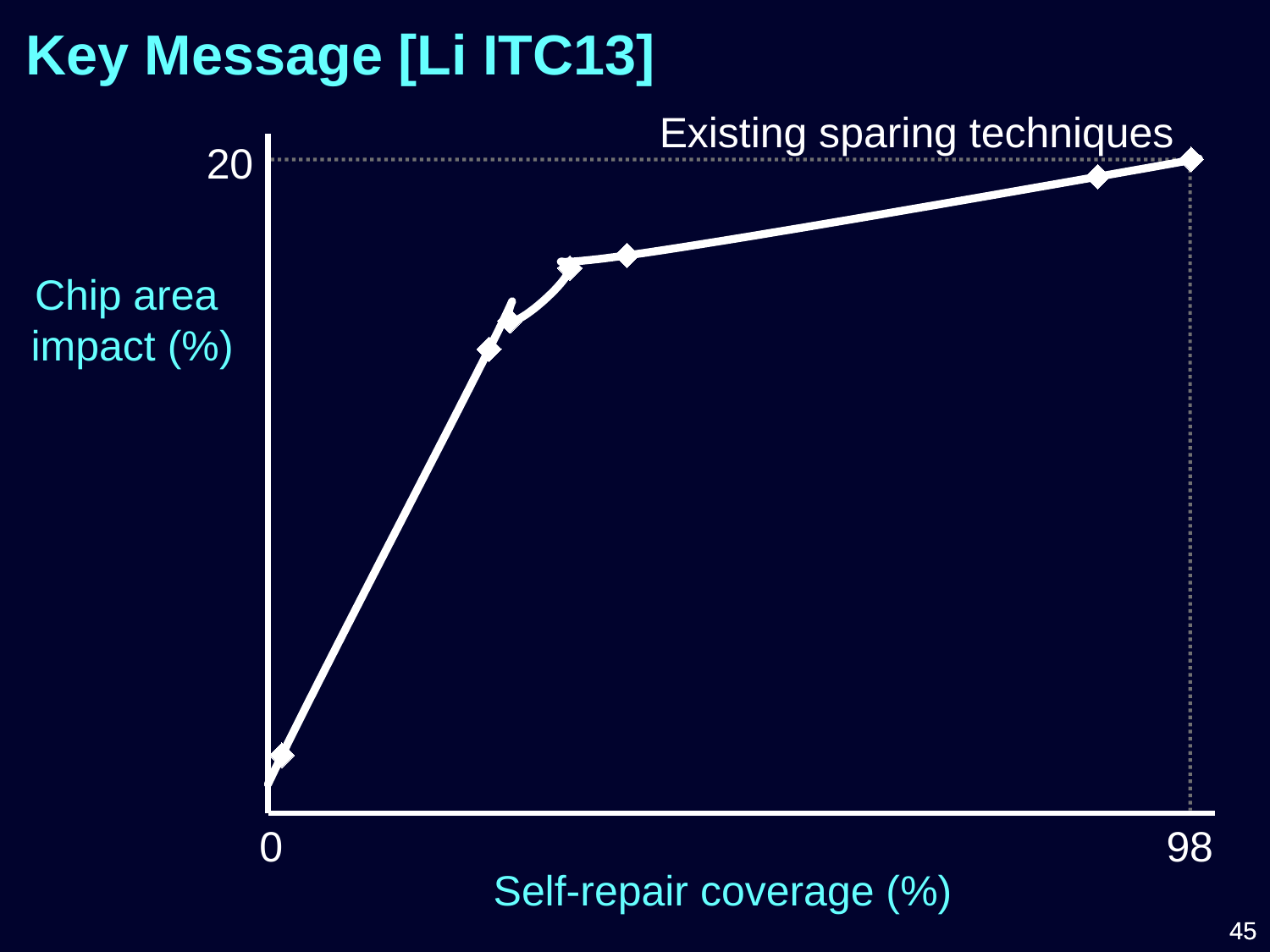
At which self-repair coverage value is the chip area impact lowest? 0 What is the highest value shown on the x axis? 98 What kind of chart is shown on the slide? line chart What is the label of the x axis? Self-repair coverage (%) What is the label of the y axis? Chip area impact (%) Is the chip area impact at a self-repair coverage of 0% greater or less than 20? less At which self-repair coverage value is the chip area impact highest? 98 Which has the larger chip area impact: self-repair coverage of 0% or 98%? 98% Does the chip area impact rise or fall as self-repair coverage increases? rises